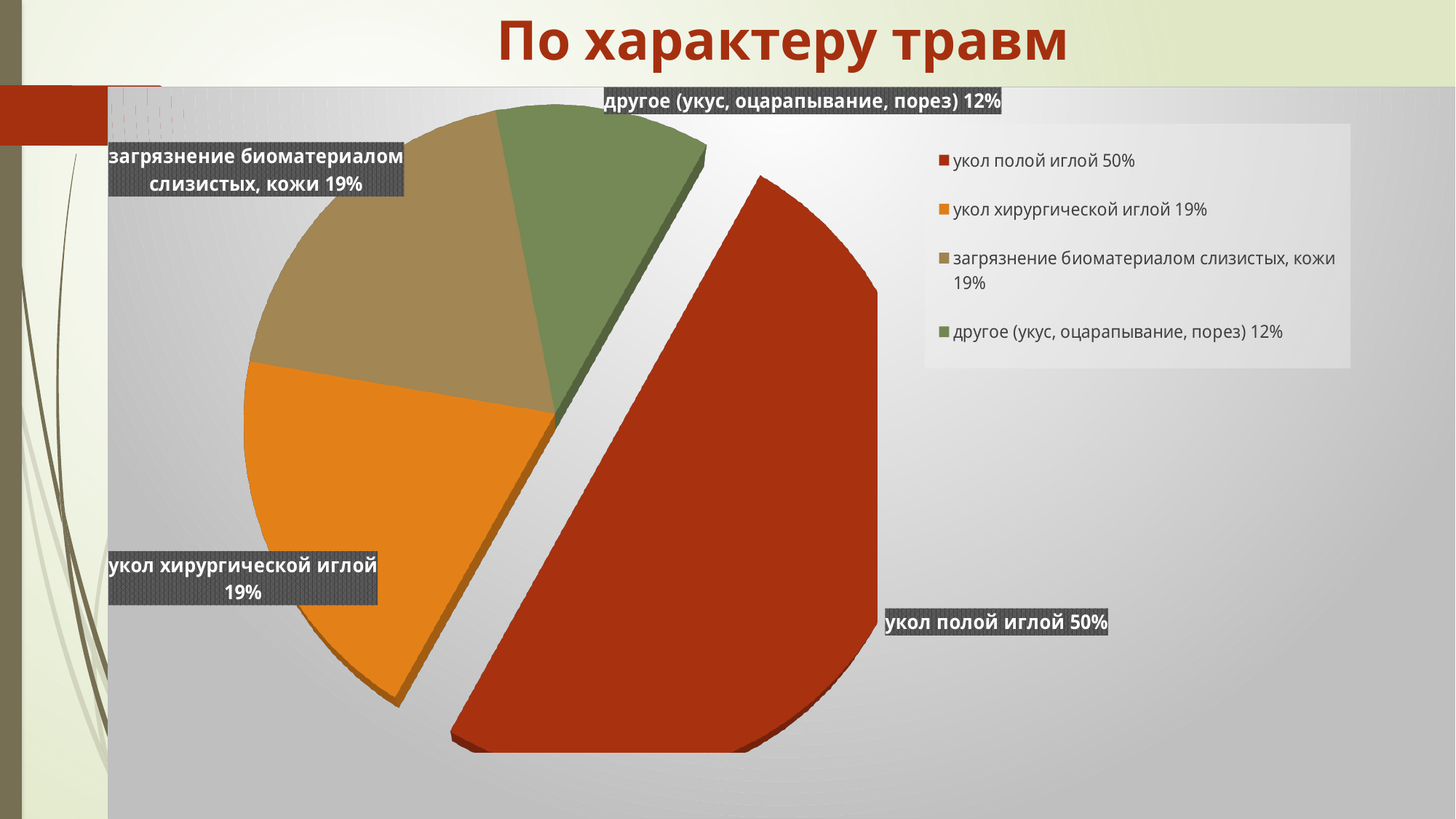
How many slices does the pie chart have? 4 What share of the pie is "укол хирургической иглой"? 19% What is the title of the chart? По характеру травм Which category has the smallest share of the pie? другое (укус, оцарапывание, порез) What is the difference between the share for "укол полой иглой" and the share for "другое (укус, оцарапывание, порез)"? 38% What share of the pie is "другое (укус, оцарапывание, порез)"? 12% Which is larger: the share for "укол хирургической иглой" or the share for "другое (укус, оцарапывание, порез)"? укол хирургической иглой What share of the pie is "укол полой иглой"? 50% Which category has the largest share of the pie? укол полой иглой What colour is the slice for "укол полой иглой"? red What kind of chart is shown on the slide? pie chart